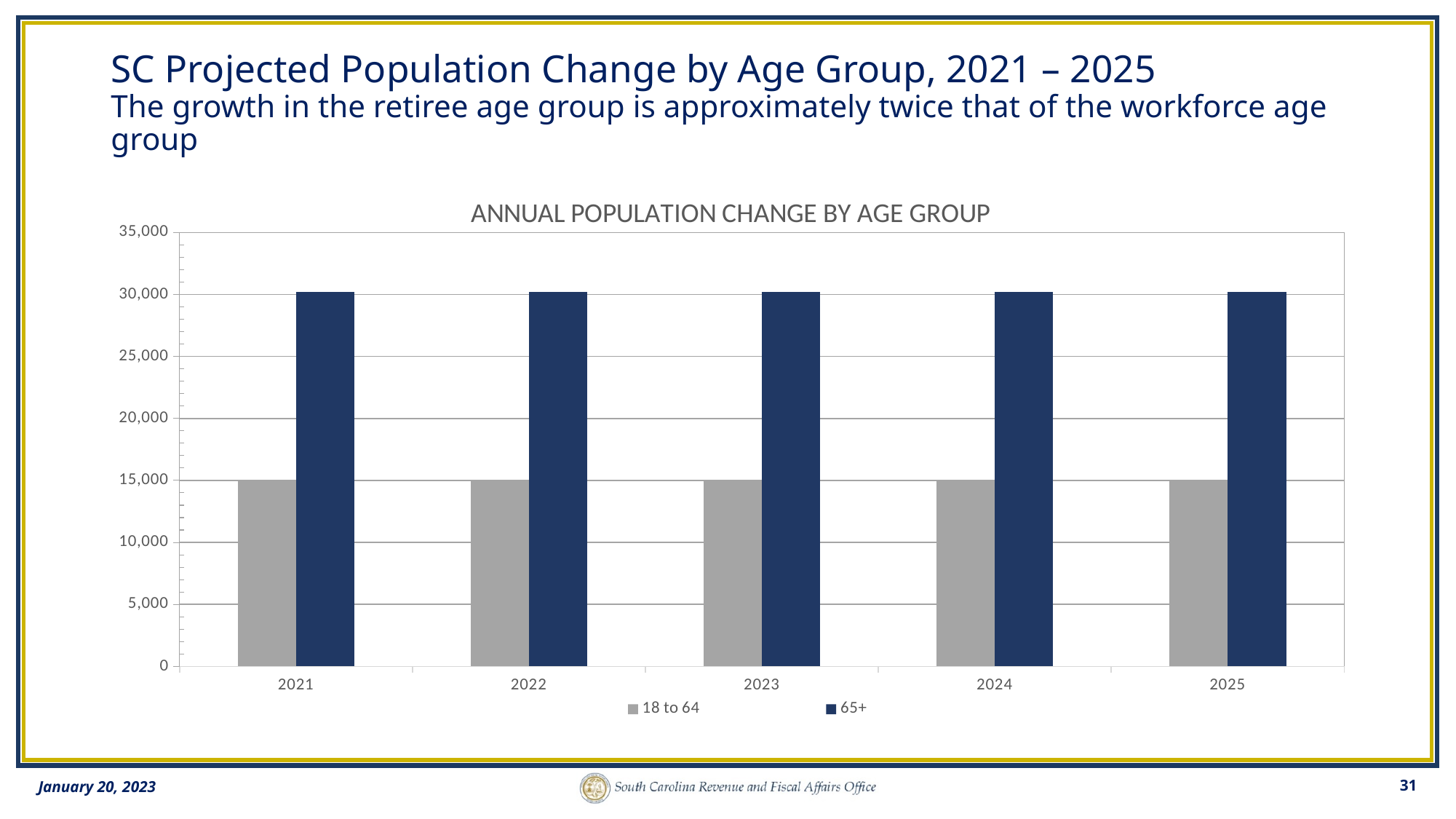
How many years are shown on the x axis? 5 Is the value for 18 to 64 in 2025 greater or less than 10,000? greater Do the values for 65+ rise, fall, or stay roughly flat from 2021 to 2025? stay roughly flat How many series does the legend list? 2 Which series has the lower values across all years? 18 to 64 Which series is shown in dark blue? 65+ Is the value for 65+ in 2021 greater or less than 25,000? greater Is the value for 65+ in 2024 greater or less than 35,000? less What kind of chart is shown on the slide? bar chart Which series has the larger value in 2022, 18 to 64 or 65+? 65+ What is the title of the chart? ANNUAL POPULATION CHANGE BY AGE GROUP